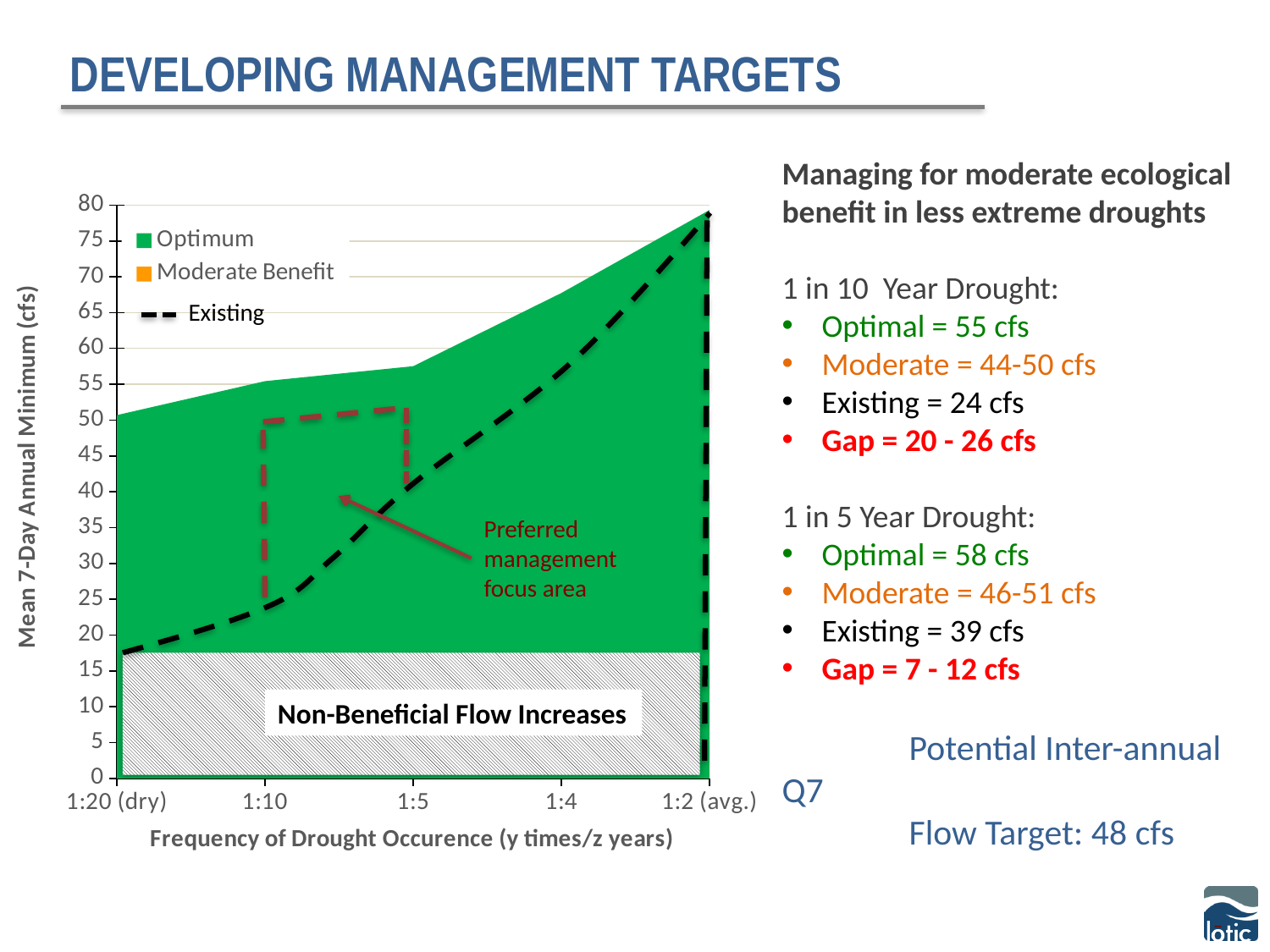
Does the Optimum series rise or fall moving from 1:20 (dry) to 1:2 (avg.) along the x axis? rise How many series does the chart legend list? 3 At which x-axis category does the Optimum series reach its highest value? 1:2 (avg.) What label is printed on the hatched area at the bottom of the chart? Non-Beneficial Flow Increases At 1:10, which is larger, the Optimum value or the Existing value? Optimum How many categories are shown on the x axis of the chart? 5 Is the Optimum value at 1:4 greater or less than 60? greater Is the Optimum value at 1:2 (avg.) greater or less than 75? greater At which x-axis category is the Existing series lowest? 1:20 (dry) What kind of chart is shown on the slide? area chart Is the Existing value at 1:20 (dry) greater or less than 20? less What is the title of the chart's y axis? Mean 7-Day Annual Minimum (cfs)